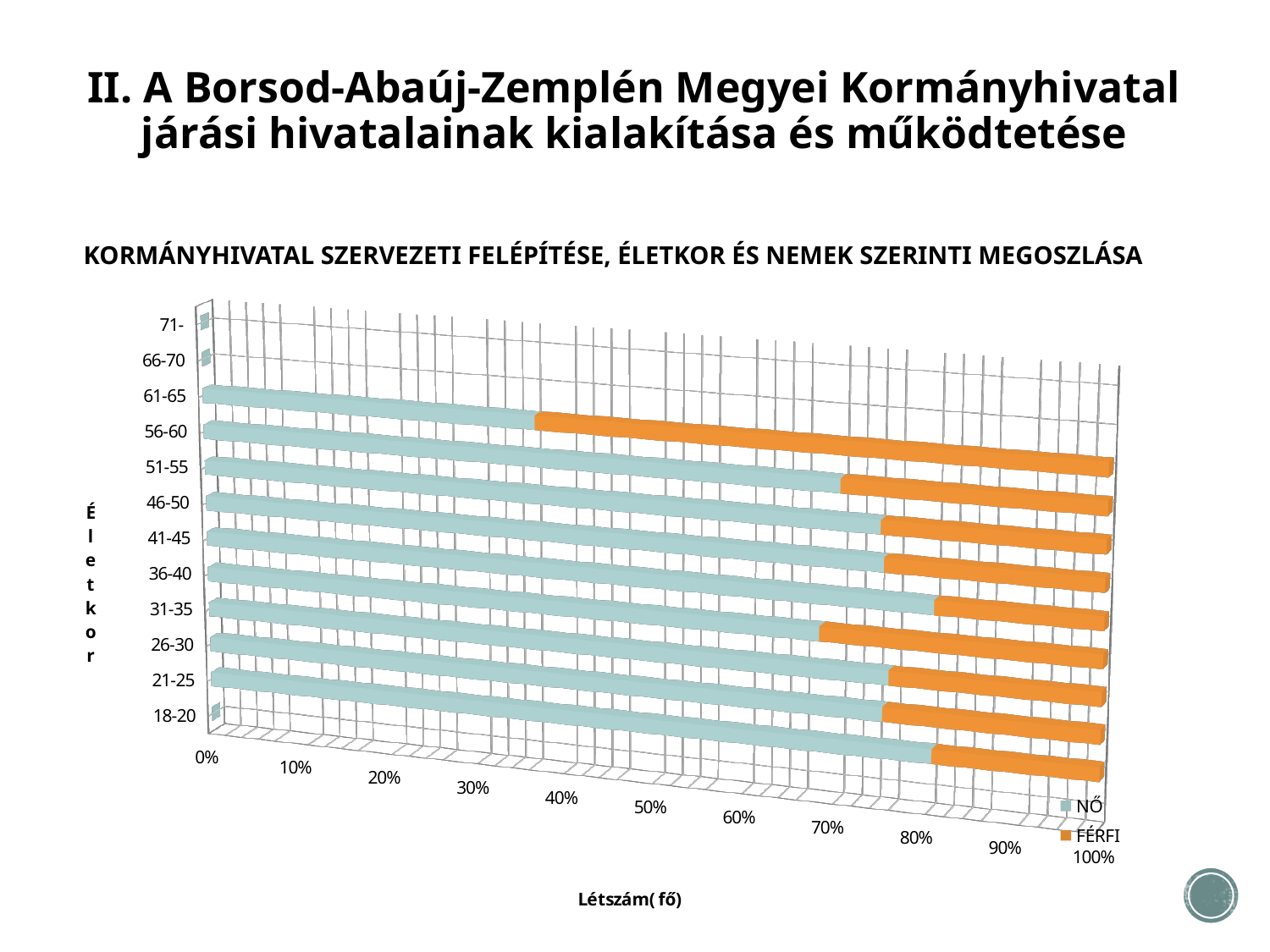
What is the highest percentage tick shown on the horizontal axis? 100% What kind of chart is shown on the slide? Stacked bar chart Is the NŐ share for the 61-65 age group greater or less than 50%? less Is the NŐ share for the 36-40 age group greater or less than 50%? greater What is the title of the chart? KORMÁNYHIVATAL SZERVEZETI FELÉPÍTÉSE, ÉLETKOR ÉS NEMEK SZERINTI MEGOSZLÁSA Which age group has the largest FÉRFI share? 61-65 Is the FÉRFI share for the 61-65 age group greater or less than 50%? greater How many age-group categories are shown on the vertical axis of the chart? 12 Which two series are listed in the chart legend? NŐ and FÉRFI How many series does the chart legend list? 2